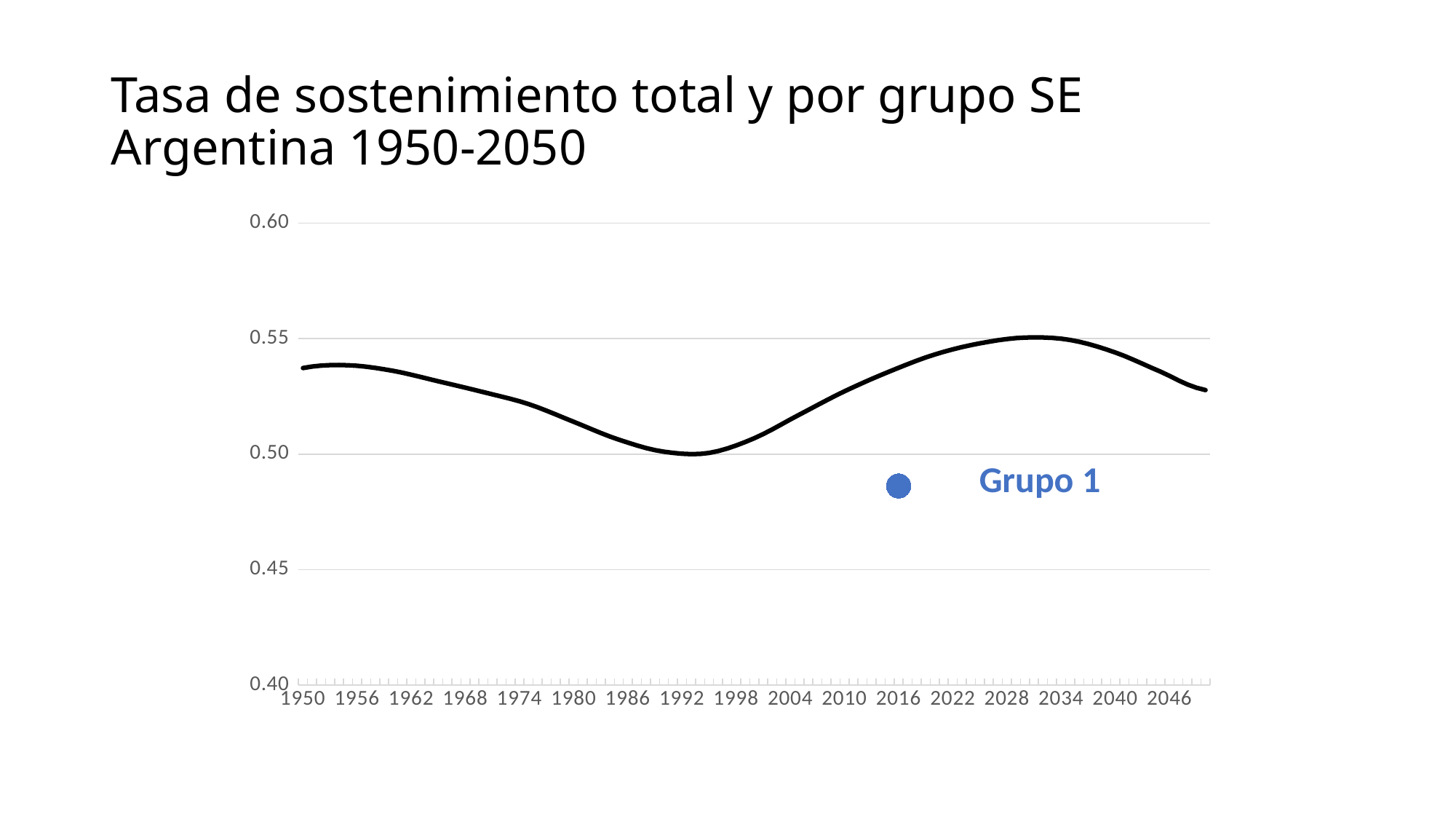
What kind of chart is shown on the slide? line chart What is the highest value shown on the vertical axis? 0.60 Is the value of the line in 2010 greater or less than 0.50? greater Is the value of the line in 1950 greater or less than 0.50? greater Is the value of the line in 1950 greater or less than 0.55? less Does the line rise or fall between 1992 and 2028? rise Does the line rise or fall between 1950 and 1992? fall Which is larger, the value of the line in 1950 or in 1992? 1950 What is the title of the chart on the slide? Tasa de sostenimiento total y por grupo SE Argentina 1950-2050 Which is larger, the value of the line in 2028 or in 1992? 2028 Around which labeled year does the line reach its lowest point? 1992